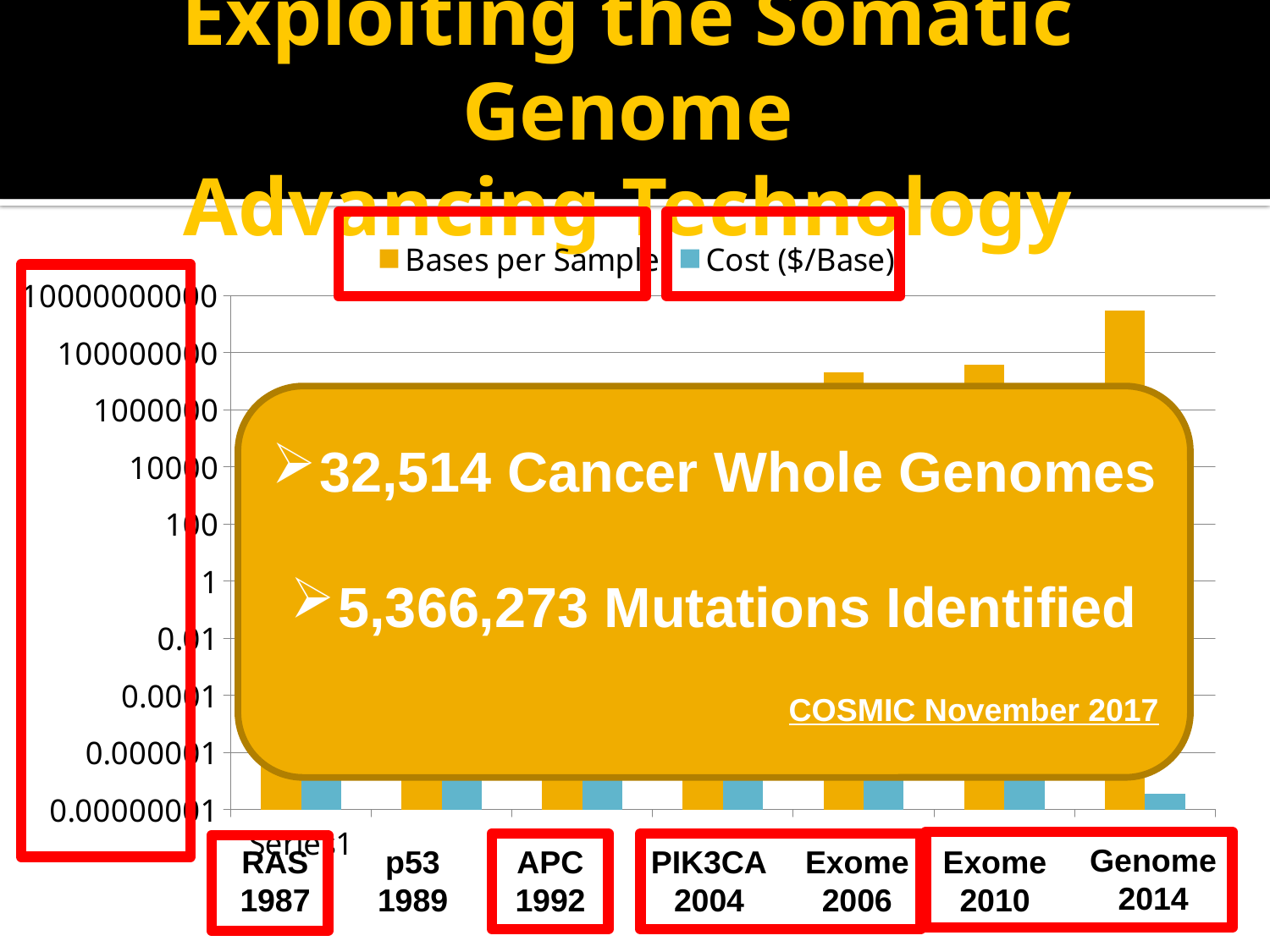
Is the Cost ($/Base) value for Genome 2014 greater or less than 0.000001? less What are the two series named in the chart legend? Bases per Sample and Cost ($/Base) How many categories are shown along the x axis of the chart? 7 Which is larger, the Bases per Sample value for Genome 2014 or for Exome 2010? Genome 2014 Is the Bases per Sample value for Genome 2014 greater or less than 100000000? greater Which category has the lowest Cost ($/Base) value? Genome 2014 What is the highest value shown on the chart's y axis? 10000000000 How many series does the chart legend list? 2 Which category has the highest Bases per Sample value? Genome 2014 What kind of chart is shown on the slide? bar chart Is the Bases per Sample value for Exome 2006 greater or less than 1000000? greater